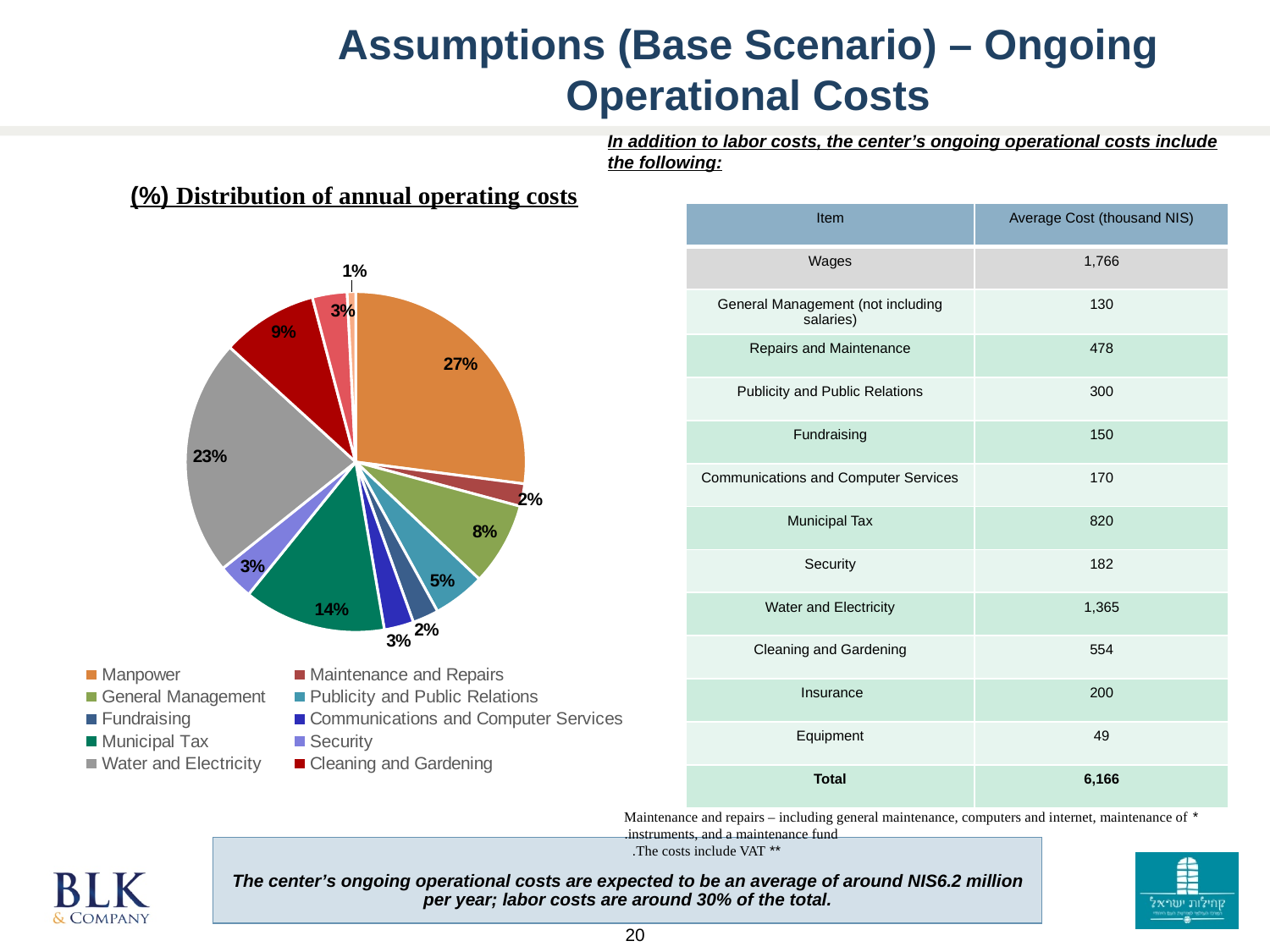
What percentage of annual operating costs does Manpower account for in the pie chart? 27% What is the title of the chart on the slide? (%) Distribution of annual operating costs Which has a larger share of annual operating costs in the pie chart, Municipal Tax or Cleaning and Gardening? Municipal Tax What type of chart is shown on the slide? Pie chart What percentage of annual operating costs does Cleaning and Gardening account for in the pie chart? 9% Which category has the largest share of annual operating costs in the pie chart? Manpower How many entries does the legend of the pie chart list? 10 What percentage of annual operating costs does Municipal Tax account for in the pie chart? 14% By how many percentage points does the Manpower share exceed the Water and Electricity share in the pie chart? 4 percentage points What is the smallest percentage shown on any slice of the pie chart? 1% What percentage of annual operating costs does Publicity and Public Relations account for in the pie chart? 5% What percentage of annual operating costs does Water and Electricity account for in the pie chart? 23%